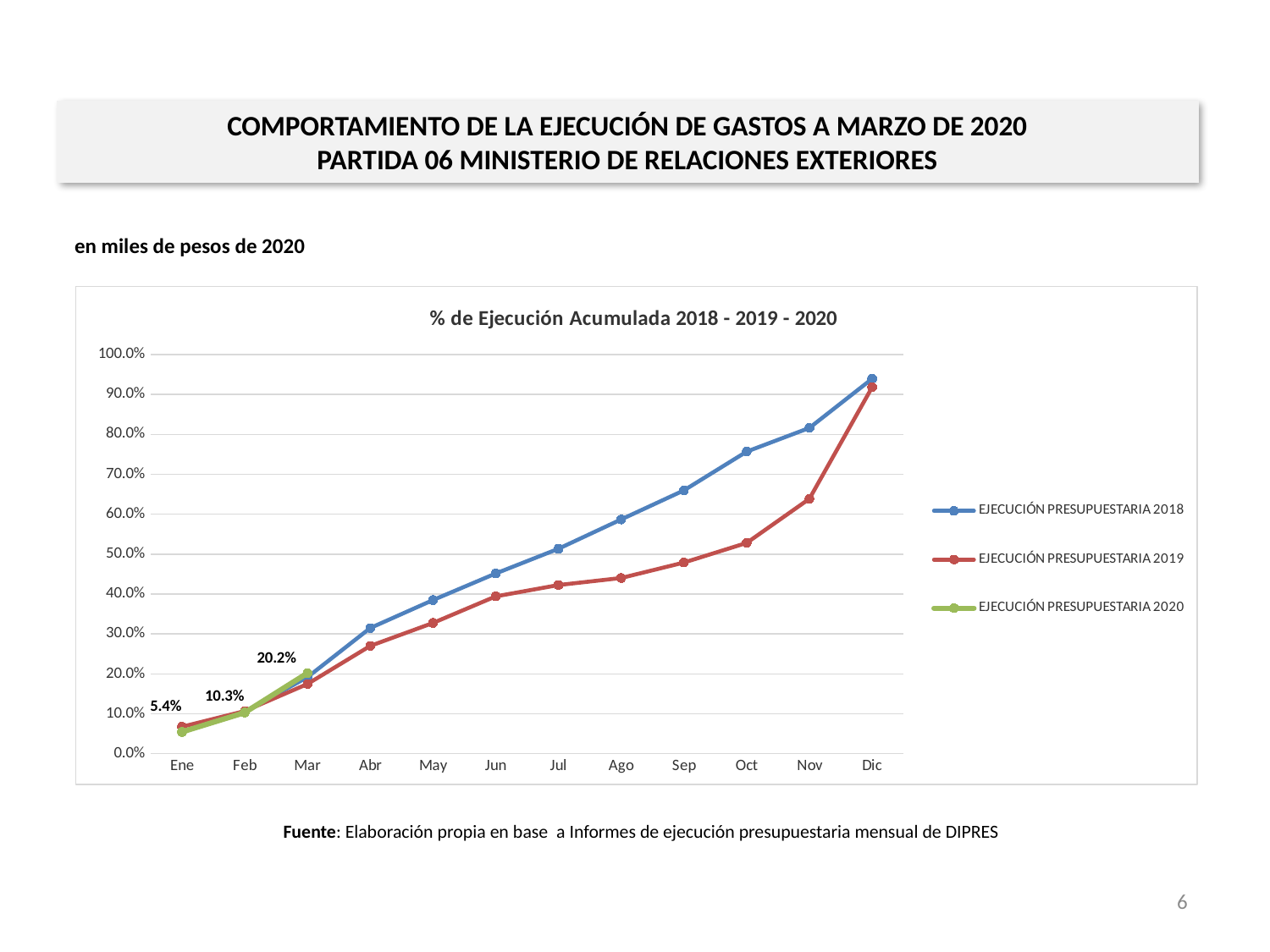
How many series does the legend list? 3 How many months are shown on the x axis? 12 What is the value for EJECUCIÓN PRESUPUESTARIA 2020 in Ene? 5.4% Is the value for EJECUCIÓN PRESUPUESTARIA 2018 in Dic greater or less than 90.0%? greater Is the value for EJECUCIÓN PRESUPUESTARIA 2019 in Nov greater or less than 60.0%? greater By how much did EJECUCIÓN PRESUPUESTARIA 2020 increase from Feb to Mar? 9.9% What is the value for EJECUCIÓN PRESUPUESTARIA 2020 in Feb? 10.3% What is the value for EJECUCIÓN PRESUPUESTARIA 2020 in Mar? 20.2% In Oct, which series has the higher value, EJECUCIÓN PRESUPUESTARIA 2018 or EJECUCIÓN PRESUPUESTARIA 2019? EJECUCIÓN PRESUPUESTARIA 2018 Does the EJECUCIÓN PRESUPUESTARIA 2018 line rise or fall from Ene to Dic? rise What kind of chart is shown on the slide? line chart What is the title of the chart? % de Ejecución Acumulada 2018 - 2019 - 2020